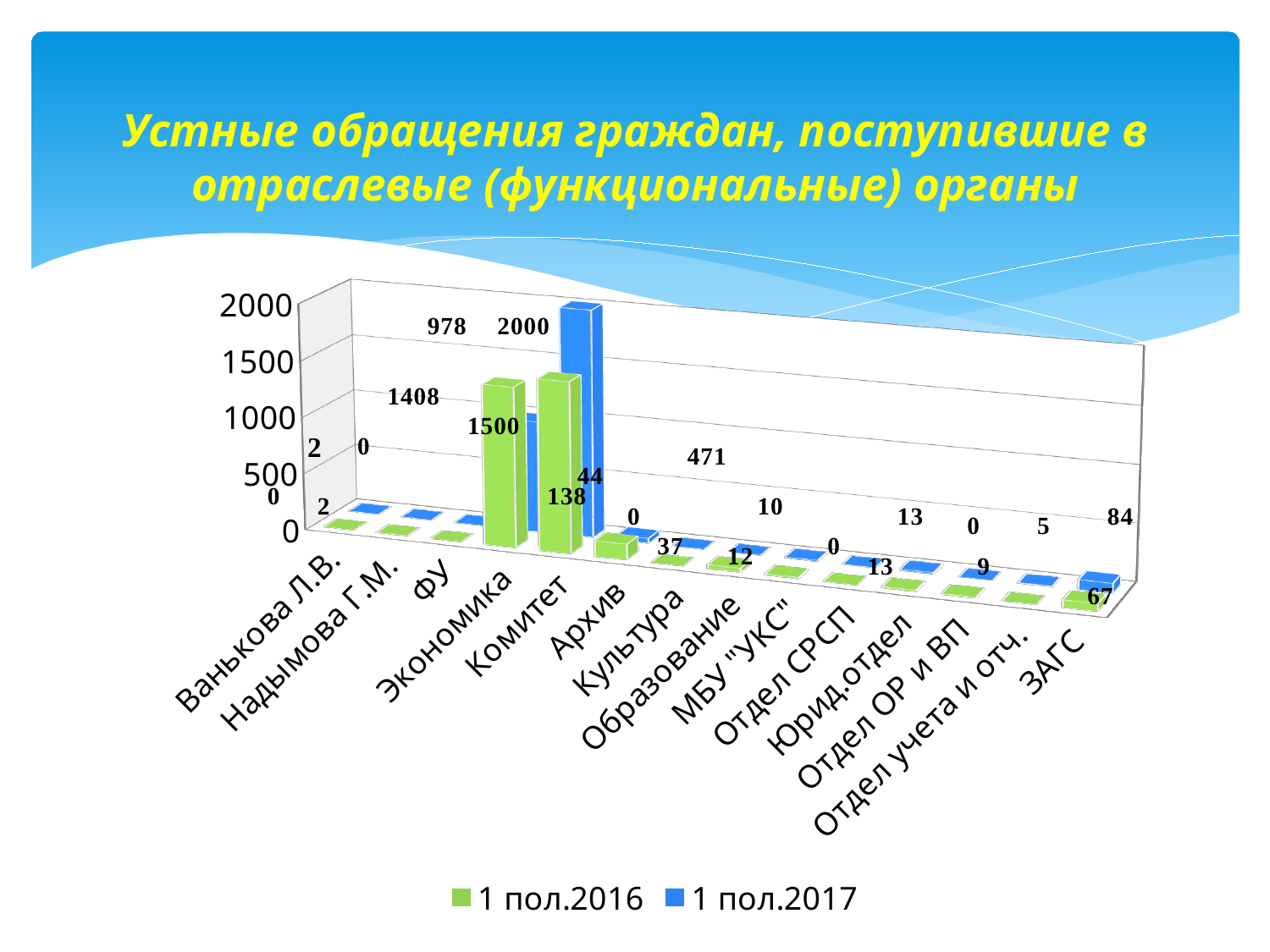
What is the title of the chart? Устные обращения граждан, поступившие в отраслевые (функциональные) органы Which category has the highest value for 1 пол.2017? Комитет How many categories are shown along the x axis? 14 What kind of chart is shown on the slide? bar chart How many series does the legend list? 2 Which is larger for 1 пол.2017: Комитет or Экономика? Комитет What is the value for Комитет in 1 пол.2017? 2000 What are the two series named in the legend? 1 пол.2016 and 1 пол.2017 Is the value for ЗАГС in 1 пол.2017 greater or less than 500? less Is the value for Экономика in 1 пол.2016 greater or less than 1000? greater Is the value for Экономика in 1 пол.2017 greater or less than 1500? less